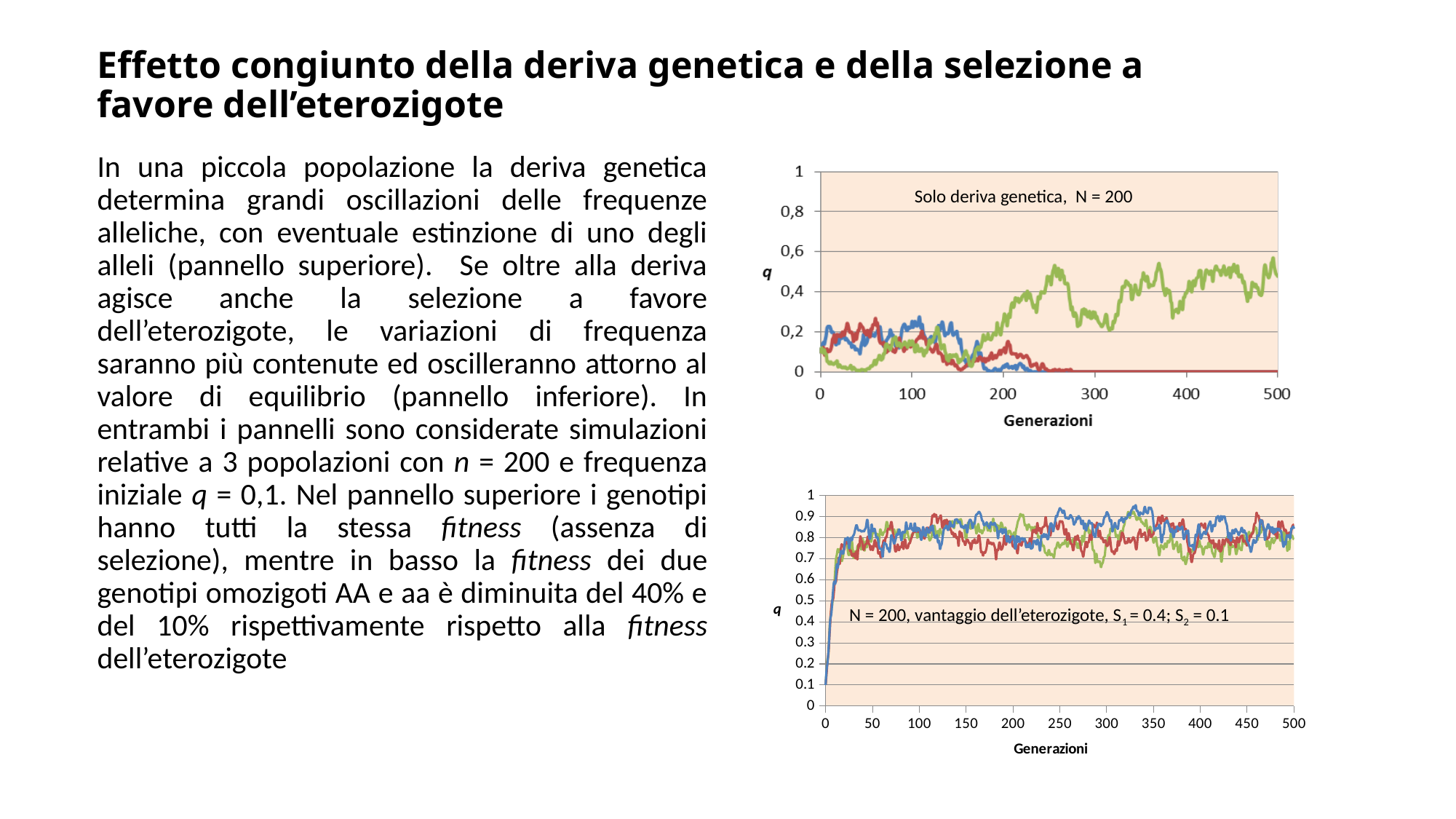
In the top chart, is the value of the red line at generation 400 greater or less than 0,2? less What kind of chart is the top chart (Solo deriva genetica, N = 200)? line chart What text annotation appears inside the plot area of the top chart? Solo deriva genetica, N = 200 In the bottom chart, how many lines (populations) are plotted? 3 What is the x-axis label of the top chart? Generazioni In the bottom chart, do the values rise or fall over the first 50 generations? rise In the bottom chart, is the value of the blue line at generation 300 greater or less than 0.5? greater In the top chart, is the value of the green line at generation 500 greater or less than 0,2? greater In the top chart, how many lines (populations) are plotted? 3 What kind of chart is the bottom chart (N = 200, vantaggio dell'eterozigote)? line chart In the top chart, at generation 500, which line has the higher value, the green line or the red line? green